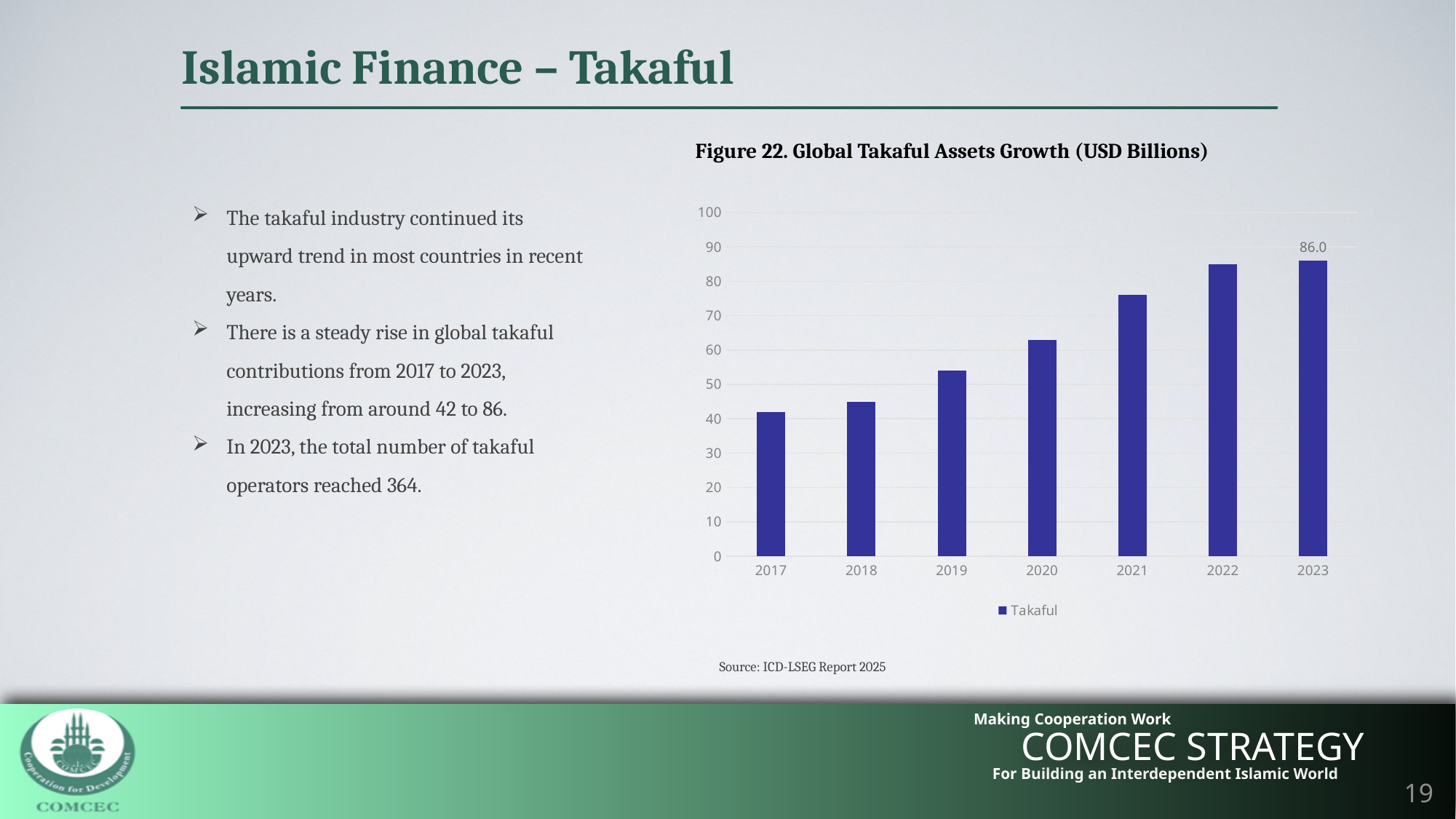
Is the value for 2018 greater or less than 50? less Is the value for 2019 greater or less than 60? less Do the values rise or fall from 2017 to 2023? Rise How many years are shown on the x axis of the chart? 7 How many series does the legend list? 1 Which year has the lowest value in the chart? 2017 What is the value for 2023 in the Global Takaful Assets Growth chart? 86.0 What kind of chart is shown on the slide? Bar chart Which year has the highest value in the chart? 2023 Which is larger, the value for 2019 or the value for 2021? 2021 Is the value for 2020 greater or less than 60? greater